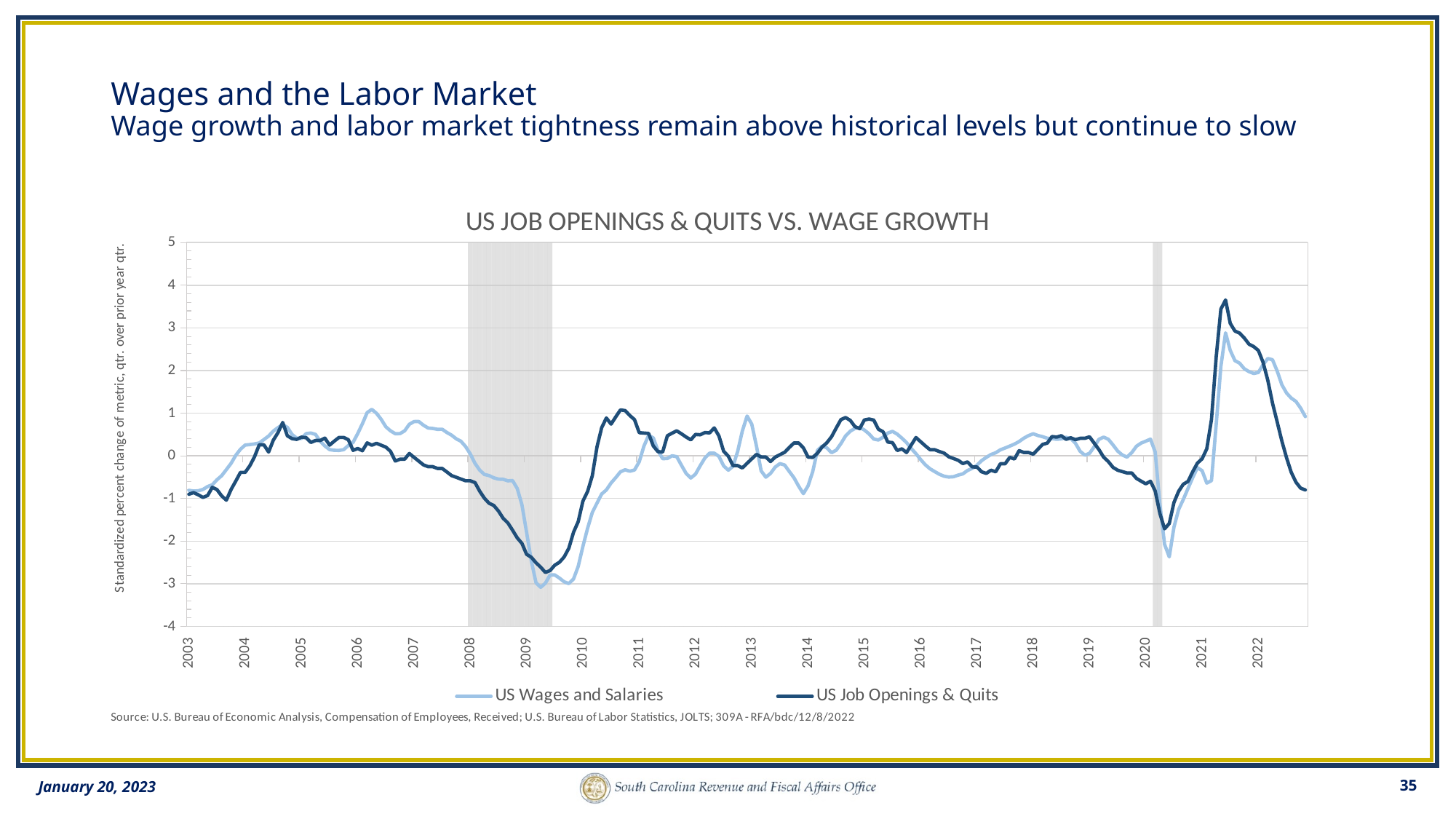
Is the peak value of US Wages and Salaries in 2021 greater or less than 2? greater Is the peak value of US Job Openings & Quits in 2021 greater or less than 3? greater What is the title of the chart? US JOB OPENINGS & QUITS VS. WAGE GROWTH How many series does the legend list? 2 Does the US Job Openings & Quits series rise or fall from its 2021 peak to the end of 2022? fall What are the two series named in the legend? US Wages and Salaries; US Job Openings & Quits Is the lowest value of US Job Openings & Quits in 2020 greater or less than -1? less In which year does the US Job Openings & Quits series reach its highest value? 2021 What kind of chart is shown on the slide? line chart Which series is lower at the end of 2022, US Wages and Salaries or US Job Openings & Quits? US Job Openings & Quits Which series reaches the higher peak in 2021, US Wages and Salaries or US Job Openings & Quits? US Job Openings & Quits